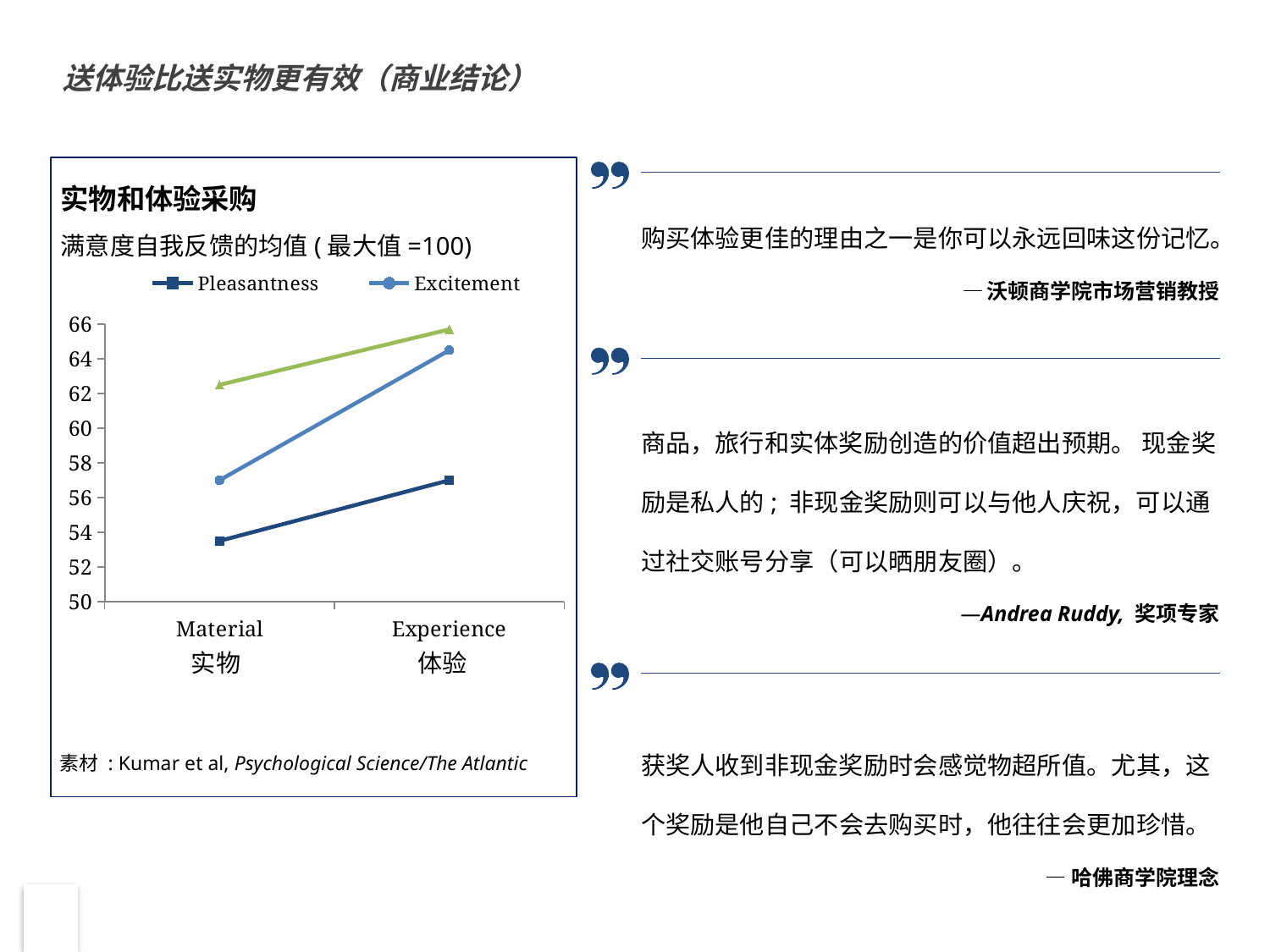
For the Excitement series, which category has the higher value? Experience Does the Pleasantness line rise or fall from Material to Experience? rise What kind of chart is shown on the slide? line chart How many categories are shown on the x axis of the chart? 2 Is the Pleasantness value for Material greater or less than 56? less How many series does the chart's legend list? 2 For Experience, which series has the larger value, Pleasantness or Excitement? Excitement Is the Excitement value for Material greater or less than 54? greater Is the Pleasantness value for Experience greater or less than 60? less Does the Excitement line rise or fall from Material to Experience? rise What is the title of the chart? 实物和体验采购